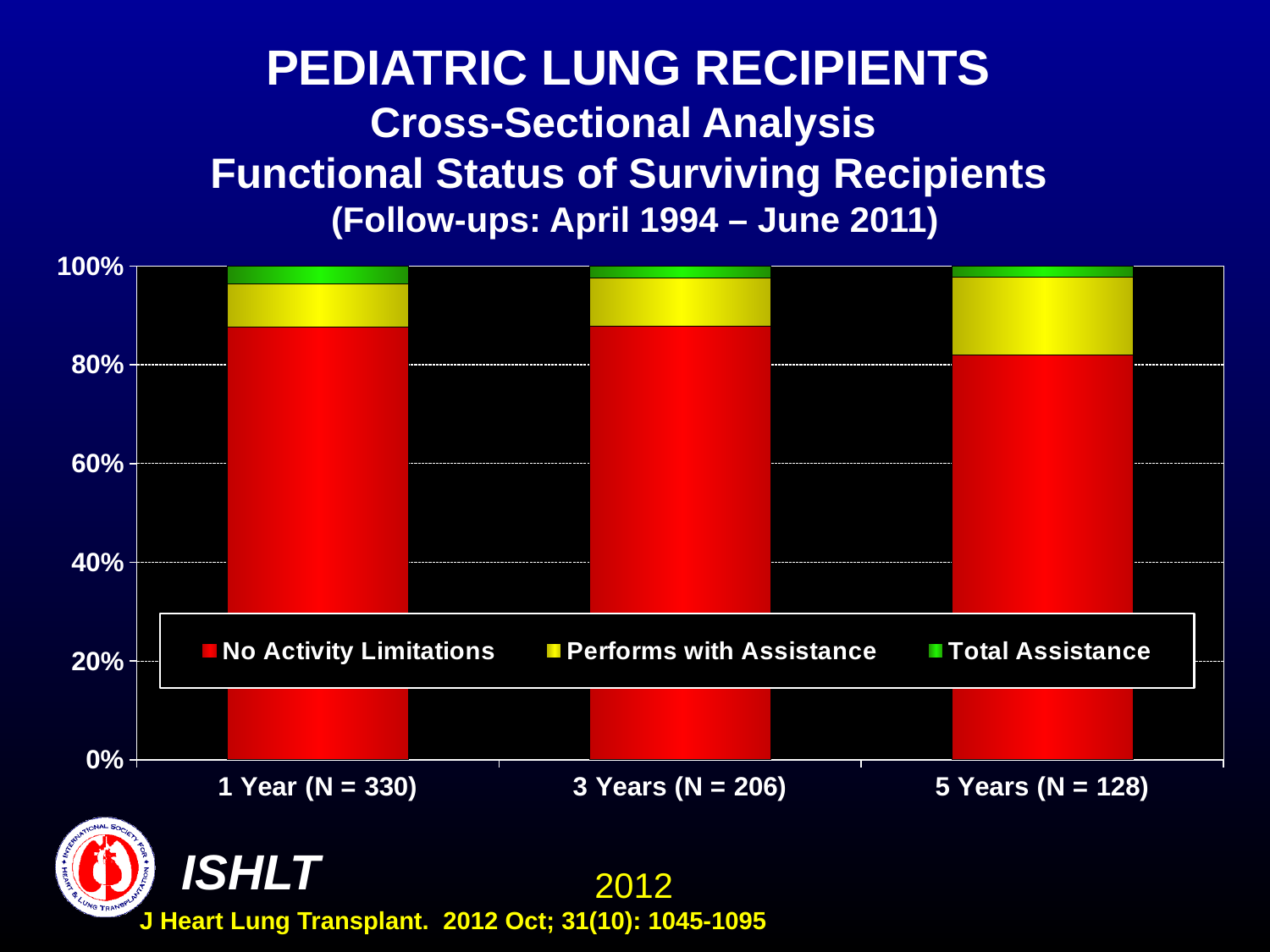
Is the No Activity Limitations share for 3 Years (N = 206) greater or less than 80%? greater Which series is shown in red? No Activity Limitations How many categories (follow-up time points) are shown on the x axis? 3 Is the No Activity Limitations share for 1 Year (N = 330) greater or less than 80%? greater What is the sample size (N) for the 5 Years category? 128 What is the sample size (N) for the 3 Years category? 206 What kind of chart is shown on the slide? stacked bar chart Which category has the smallest No Activity Limitations share? 5 Years (N = 128) Is the Performs with Assistance share for 5 Years (N = 128) greater or less than 20%? less Is the No Activity Limitations share larger at 1 Year (N = 330) or at 5 Years (N = 128)? 1 Year (N = 330) Which category has the largest Performs with Assistance share? 5 Years (N = 128) How many series does the legend list? 3